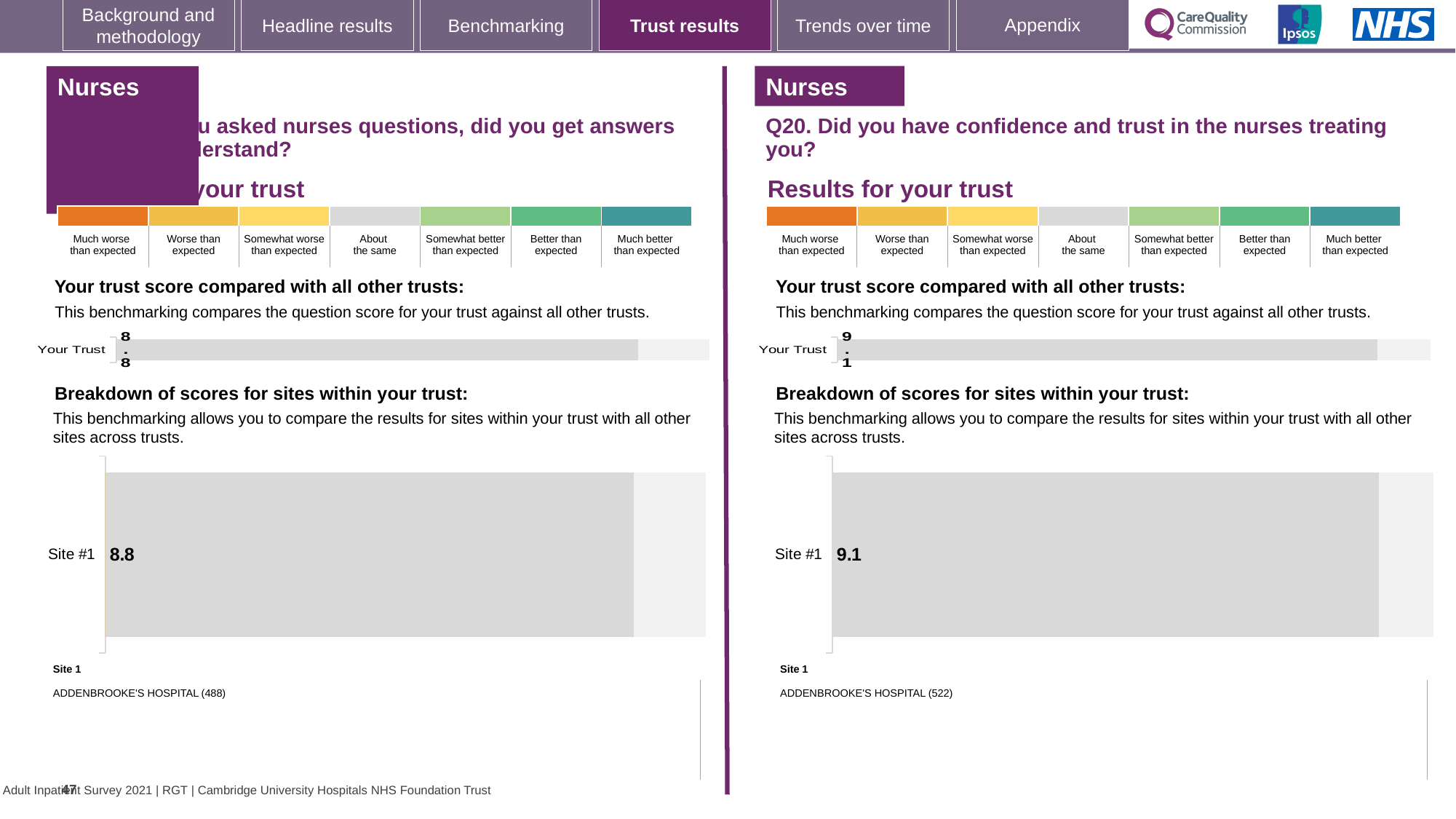
What type of chart is used to show the Site #1 score on the right-hand side (Q20)? Bar chart Which side of the slide shows the higher Site #1 score, the left-hand chart or the right-hand Q20 chart? The right-hand Q20 chart On the left-hand side of the slide, what is the score shown for Your Trust? 8.8 In the 'Breakdown of scores for sites within your trust' chart on the right-hand side (Q20), what is the score for Site #1? 9.1 Which hospital is listed as Site 1 on the right-hand side (Q20)? ADDENBROOKE'S HOSPITAL (522) Which hospital is listed as Site 1 on the left-hand side of the slide? ADDENBROOKE'S HOSPITAL (488) How many sites are shown in the 'Breakdown of scores for sites within your trust' chart on the left-hand side? 1 In the 'Breakdown of scores for sites within your trust' chart on the left-hand side, what is the score for Site #1? 8.8 What is the difference between the Site #1 score on the right-hand side (Q20) and the Site #1 score on the left-hand side? 0.3 How many sites are shown in the 'Breakdown of scores for sites within your trust' chart on the right-hand side (Q20)? 1 On the right-hand side of the slide (Q20), what is the score shown for Your Trust? 9.1